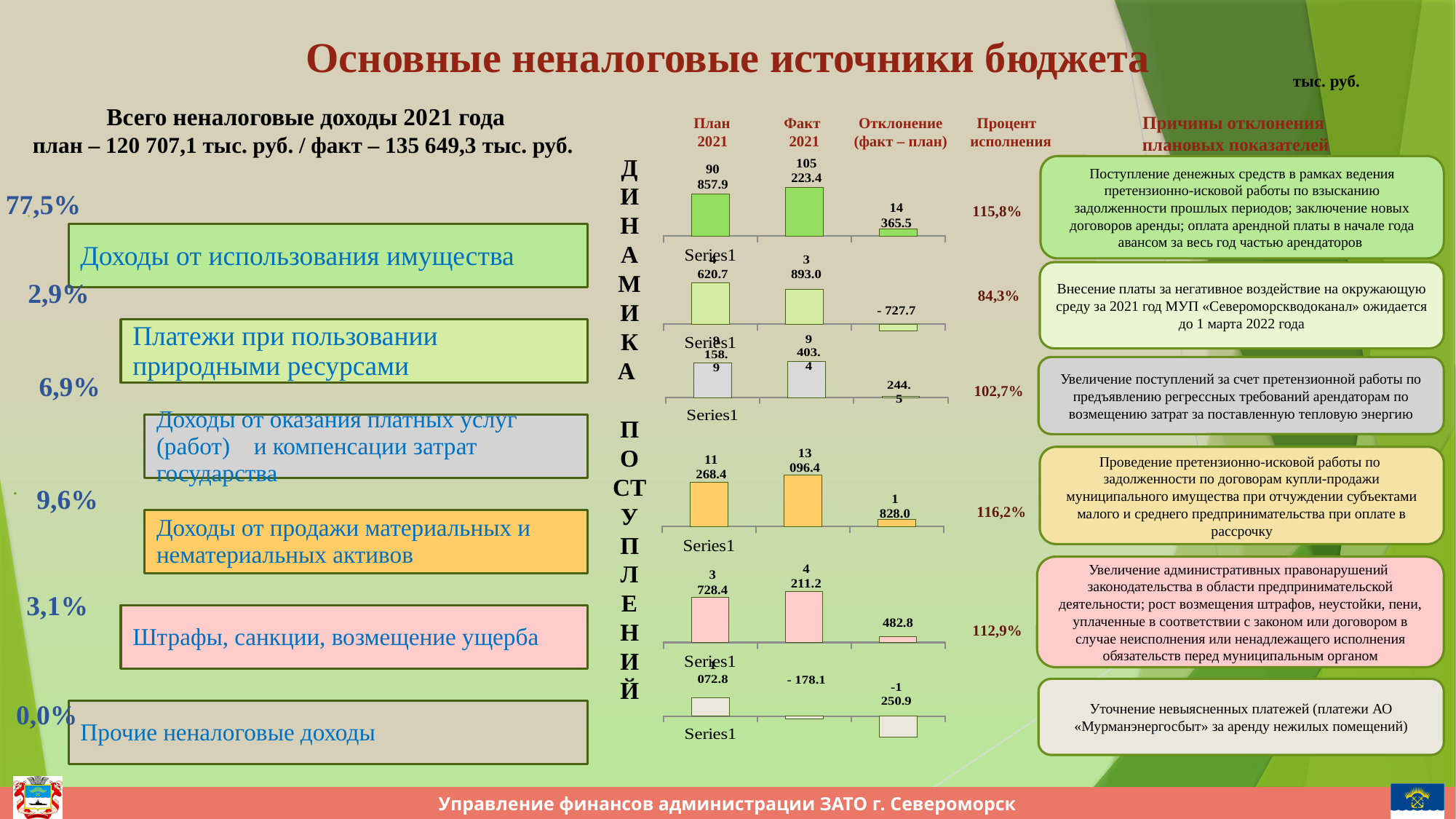
How many bars does the top chart (Доходы от использования имущества) contain? 3 In the top chart (Доходы от использования имущества), what is the value of the Отклонение (факт – план) bar? 14 365.5 In the bottom chart (Прочие неналоговые доходы), what is the value of the Отклонение (факт – план) bar? -1 250.9 In the second chart from the top (Платежи при пользовании природными ресурсами), which bar is taller: План 2021 or Факт 2021? План 2021 In the top chart (Доходы от использования имущества), what is the value of the Факт 2021 bar? 105 223.4 In the fourth chart from the top (Доходы от продажи материальных и нематериальных активов), what is the value of the Факт 2021 bar? 13 096.4 In the second chart from the top (Платежи при пользовании природными ресурсами), what is the value of the Отклонение (факт – план) bar? - 727.7 In the fifth chart from the top (Штрафы, санкции, возмещение ущерба), which bar is taller: План 2021 or Факт 2021? Факт 2021 In the fourth chart from the top (Доходы от продажи материальных и нематериальных активов), what is the value of the Отклонение (факт – план) bar? 1 828.0 What type of chart is used for the top chart (Доходы от использования имущества)? Bar chart In the fifth chart from the top (Штрафы, санкции, возмещение ущерба), what is the value of the План 2021 bar? 3 728.4 In the top chart (Доходы от использования имущества), what is the value of the План 2021 bar? 90 857.9